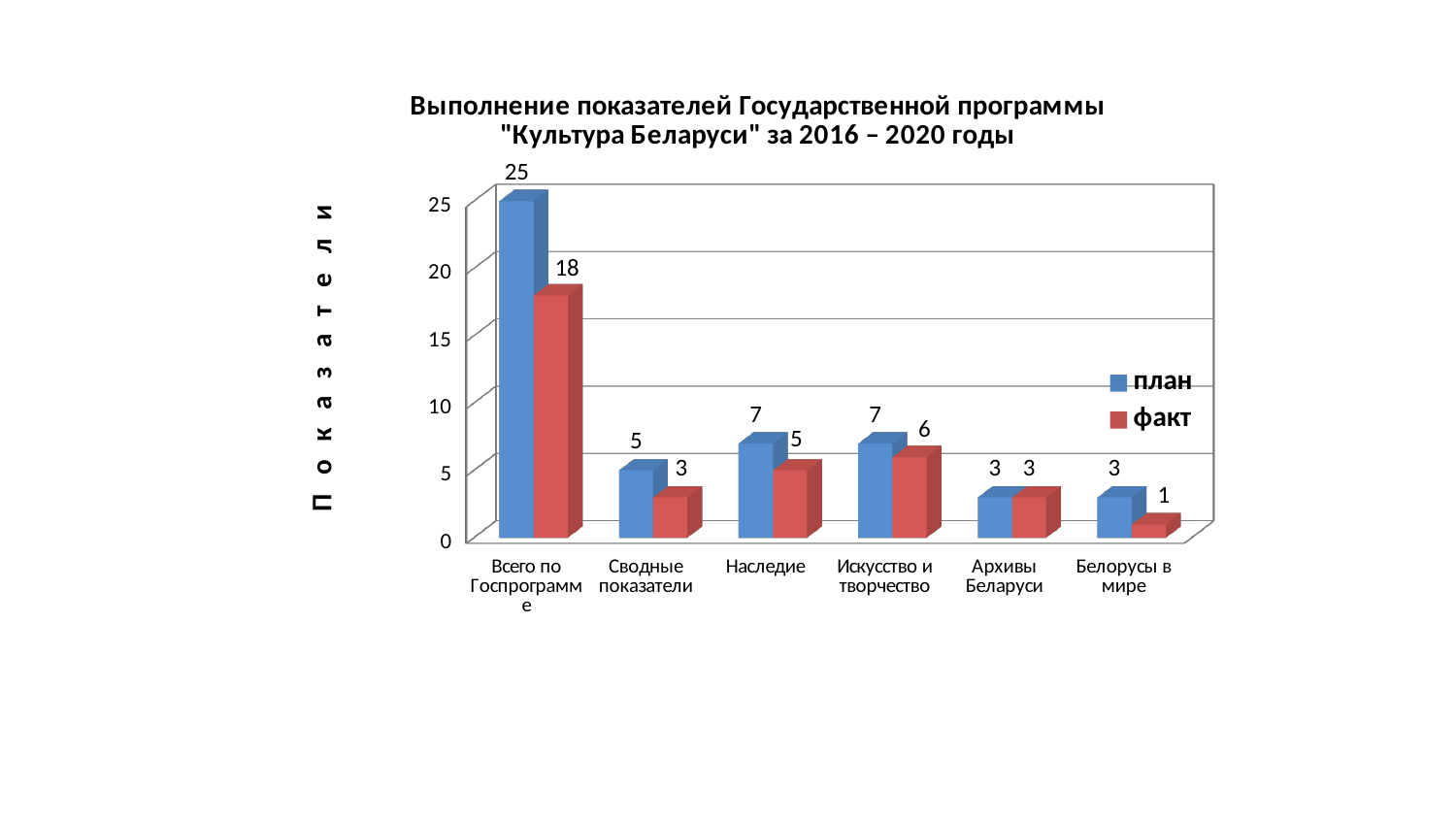
What kind of chart is shown on the slide? bar chart Which is larger for Искусство и творчество, план or факт? план What is the факт value for Белорусы в мире? 1 What is the difference between план and факт for Всего по Госпрограмме? 7 What colour are the факт bars? red Which category has the lowest факт value? Белорусы в мире How many categories are shown on the x axis? 6 How many series does the legend list? 2 What is the difference between план and факт for Сводные показатели? 2 What is the факт value for Всего по Госпрограмме? 18 What is the план value for Наследие? 7 Which category has the highest план value? Всего по Госпрограмме